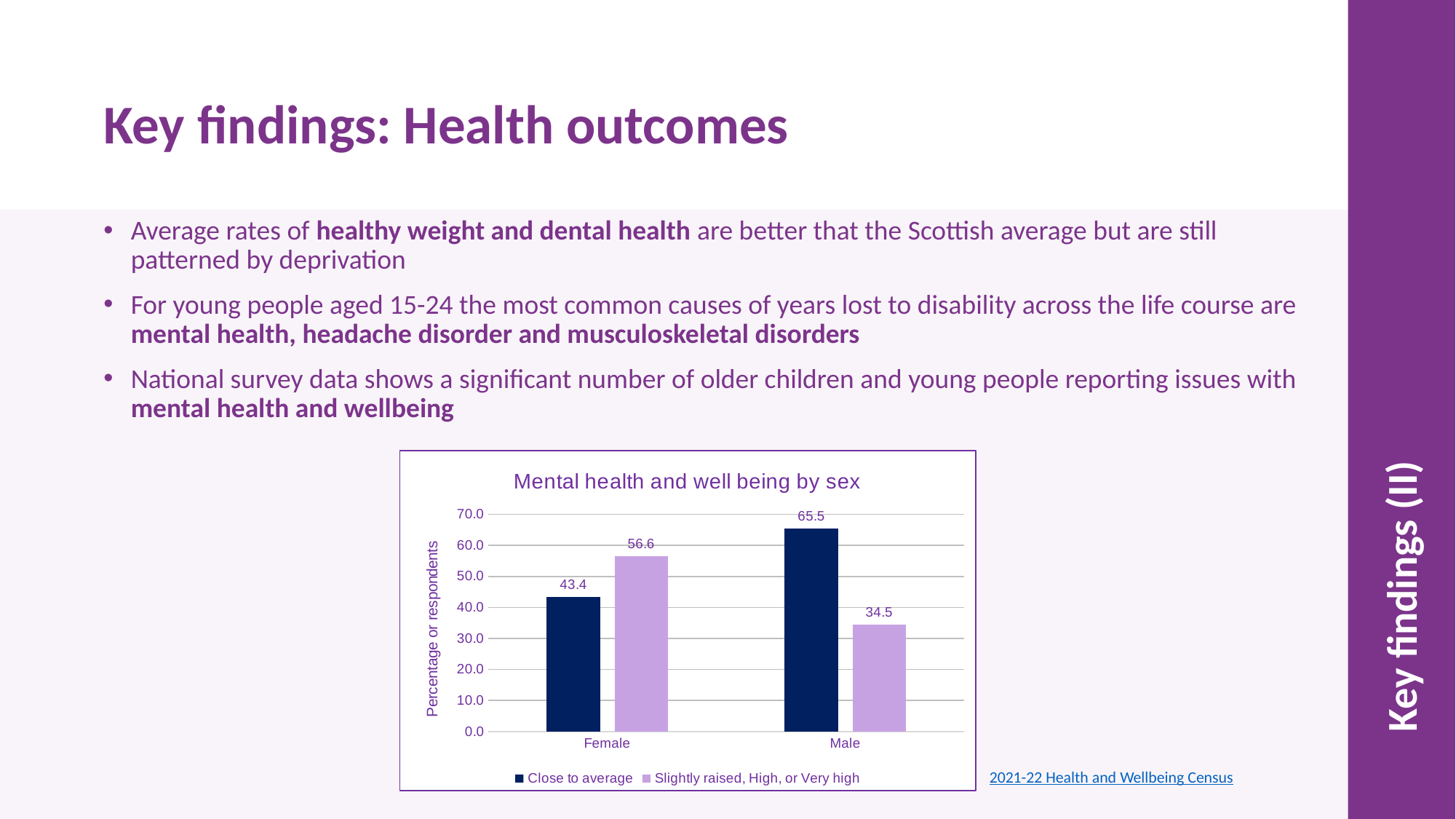
What kind of chart is shown on the slide? Bar chart Which category has the lowest value in the 'Slightly raised, High, or Very high' series? Male What is the value for Male in the 'Close to average' series? 65.5 How many categories are shown on the x axis? 2 What is the title of the chart? Mental health and well being by sex For Female, which series has the larger value: 'Close to average' or 'Slightly raised, High, or Very high'? Slightly raised, High, or Very high What is the difference between the Female and Male values in the 'Slightly raised, High, or Very high' series? 22.1 How many series does the legend list? 2 What is the value for Male in the 'Slightly raised, High, or Very high' series? 34.5 Which category has the highest value in the 'Close to average' series? Male What is the value for Female in the 'Close to average' series? 43.4 What is the difference between the Male and Female values in the 'Close to average' series? 22.1